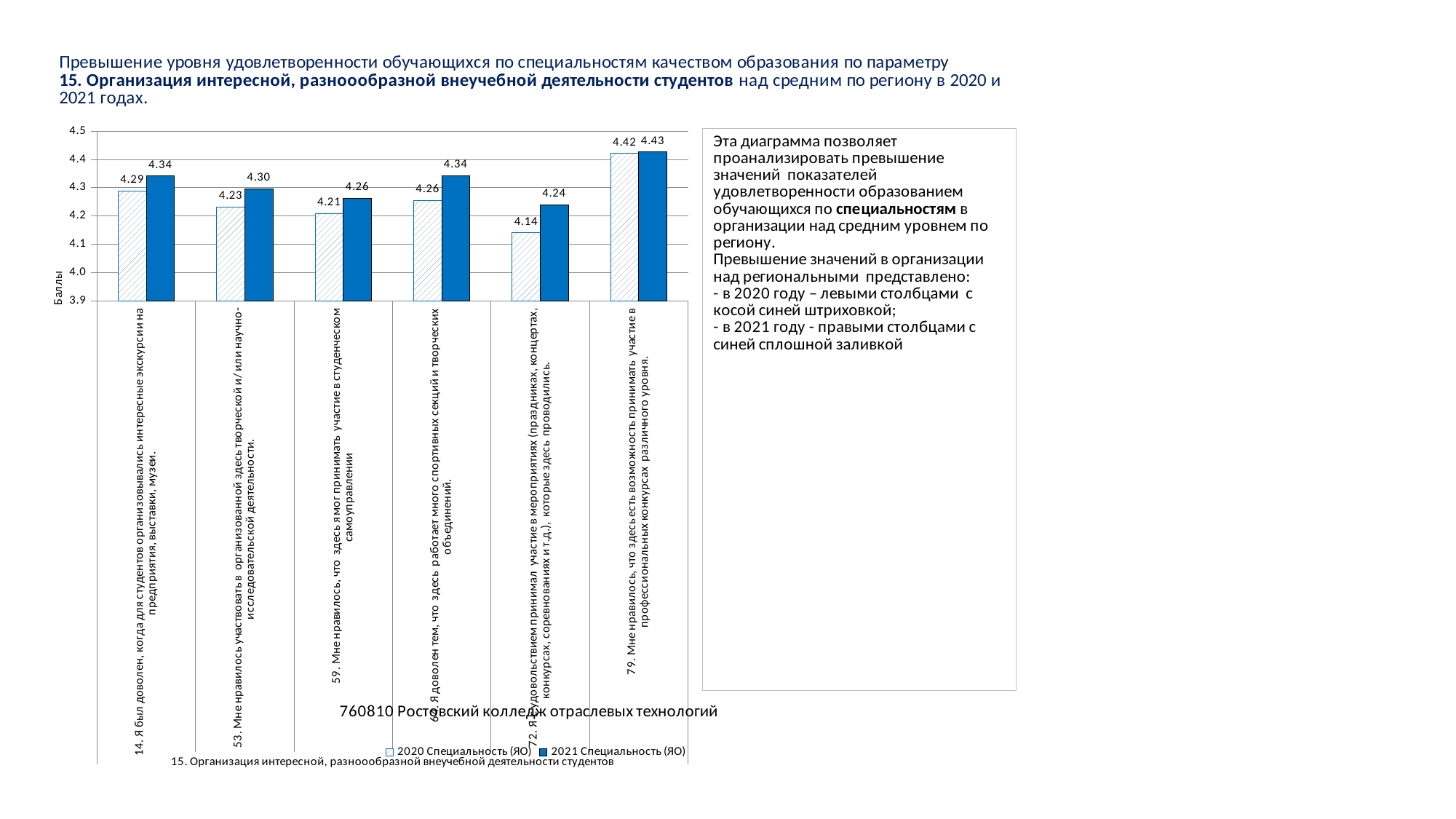
Which statement has the lowest 2020 Специальность (ЯО) value? 72. Я с удовольствием принимал участие в мероприятиях (праздниках, концертах, конкурсах, соревнованиях и т.д.), которые здесь проводились. How many series does the legend list? 2 Which is larger for statement 59: the 2020 Специальность (ЯО) value or the 2021 Специальность (ЯО) value? 2021 Специальность (ЯО) What is the 2020 Специальность (ЯО) value for statement 72 (участие в мероприятиях)? 4.14 What is the 2021 Специальность (ЯО) value for statement 14 (экскурсии, выставки, музеи)? 4.34 What is the 2021 Специальность (ЯО) value for statement 53 (творческая и/или научно-исследовательская деятельность)? 4.30 What is the label of the vertical axis? Баллы How many categories (statements) are plotted on the chart? 6 What type of chart is shown on the slide? bar chart Which statement has the highest 2021 Специальность (ЯО) value? 79. Мне нравилось, что здесь есть возможность принимать участие в профессиональных конкурсах различного уровня. What is the 2020 Специальность (ЯО) value for statement 79 (профессиональные конкурсы)? 4.42 What is the difference between the 2021 and 2020 Специальность (ЯО) values for statement 72? 0.10